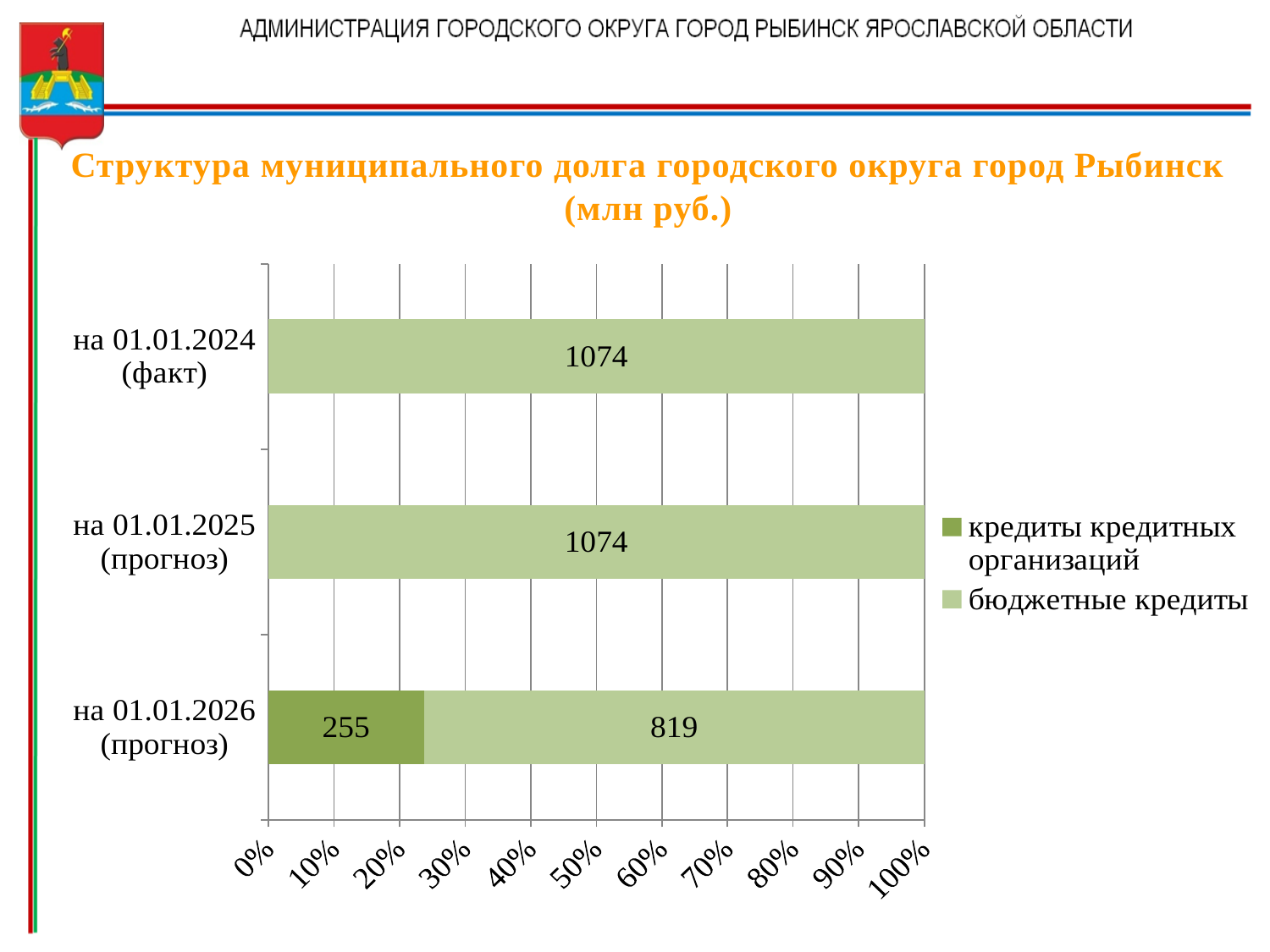
What is the value of бюджетные кредиты for на 01.01.2026 (прогноз)? 819 What is the title of the chart? Структура муниципального долга городского округа город Рыбинск (млн руб.) How many series does the legend list? 2 What is the difference between бюджетные кредиты and кредиты кредитных организаций for на 01.01.2026 (прогноз)? 564 How many categories are shown on the chart? 3 Is the share of кредиты кредитных организаций in the bar for на 01.01.2026 (прогноз) greater or less than 30%? less What is the total of the stacked bar for на 01.01.2026 (прогноз)? 1074 Which is larger for на 01.01.2026 (прогноз): бюджетные кредиты or кредиты кредитных организаций? бюджетные кредиты What is the value of бюджетные кредиты for на 01.01.2025 (прогноз)? 1074 What is the value of бюджетные кредиты for на 01.01.2024 (факт)? 1074 What is the value of кредиты кредитных организаций for на 01.01.2026 (прогноз)? 255 What kind of chart is shown on the slide? stacked bar chart